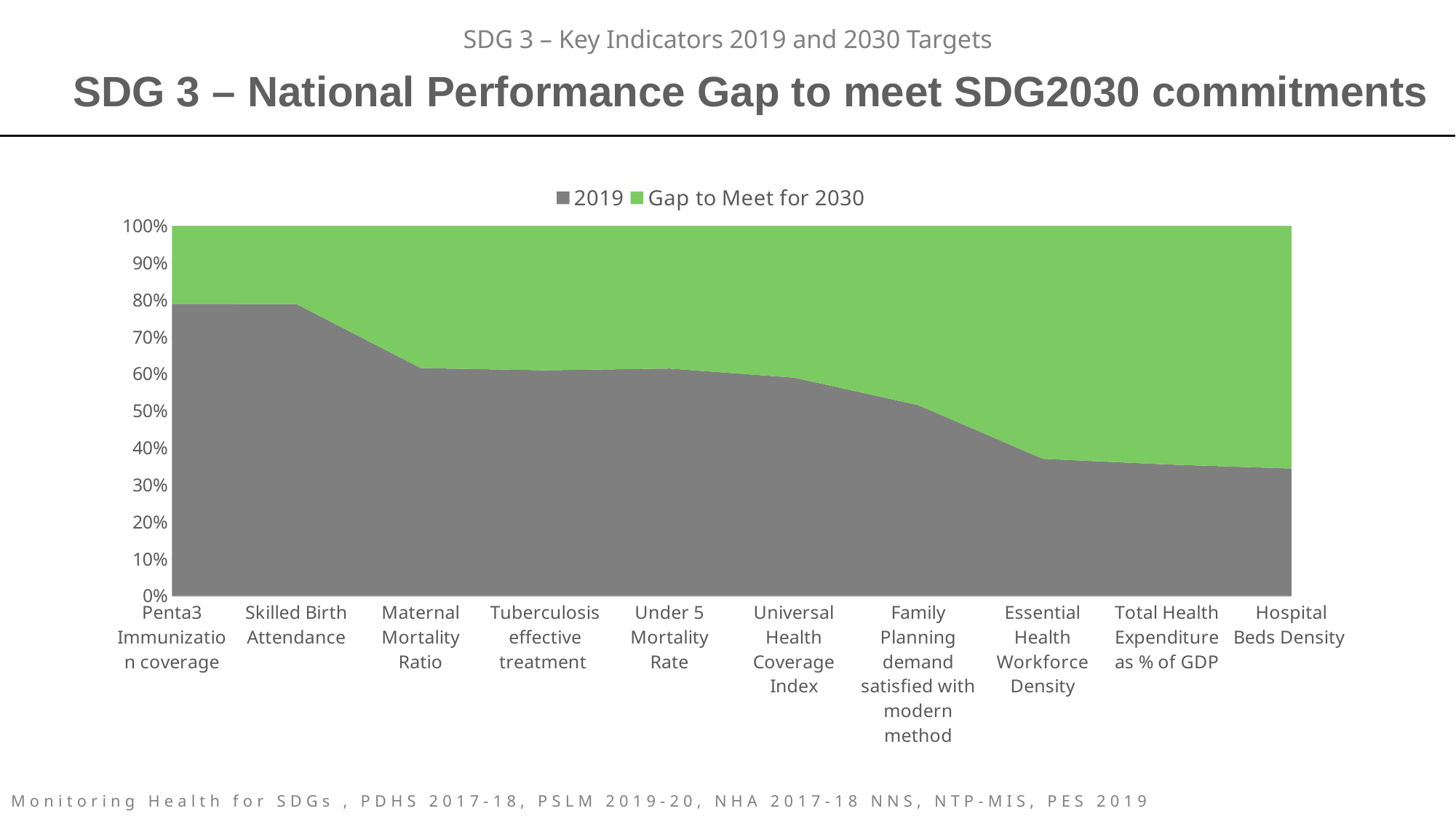
Does the 2019 series generally rise or fall moving from left to right along the x axis? Fall Which colour represents the 'Gap to Meet for 2030' series? Green Is the 2019 value for Family Planning demand satisfied with modern method greater or less than 60%? less Is the 2019 value for Hospital Beds Density greater or less than 40%? less Which has a larger 2019 value: Skilled Birth Attendance or Universal Health Coverage Index? Skilled Birth Attendance Is the 2019 value for Maternal Mortality Ratio greater or less than 50%? greater What are the two series named in the legend? 2019 and Gap to Meet for 2030 How many indicators (categories) are plotted along the x axis? 10 What kind of chart is shown on the slide? Stacked area chart How many series does the legend list? 2